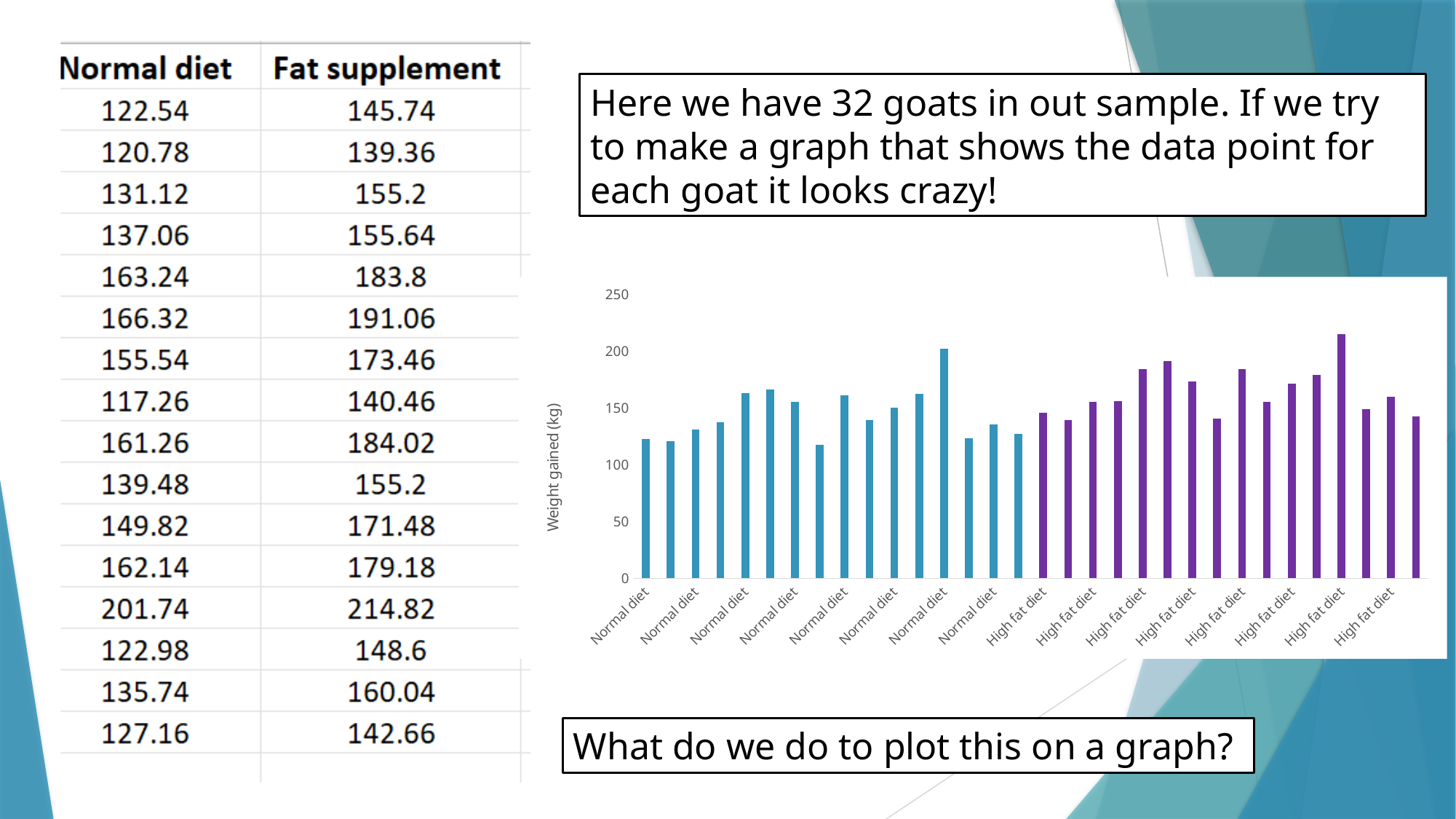
Is the tallest High fat diet bar greater or less than 200? greater How many blue (Normal diet) bars are in the chart? 16 Which diet group contains the tallest bar in the chart? High fat diet Is the shortest bar in the chart greater or less than 100? greater Is the tallest Normal diet bar greater or less than 150? greater What is the highest tick value shown on the vertical axis? 250 Which diet group contains the shortest bar in the chart? Normal diet How many bars are plotted in the chart? 32 What kind of chart is shown on the slide? Bar chart How many purple (High fat diet) bars are in the chart? 16 Which diet group generally shows higher weight gained, Normal diet or High fat diet? High fat diet What is the label on the vertical axis of the chart? Weight gained (kg)